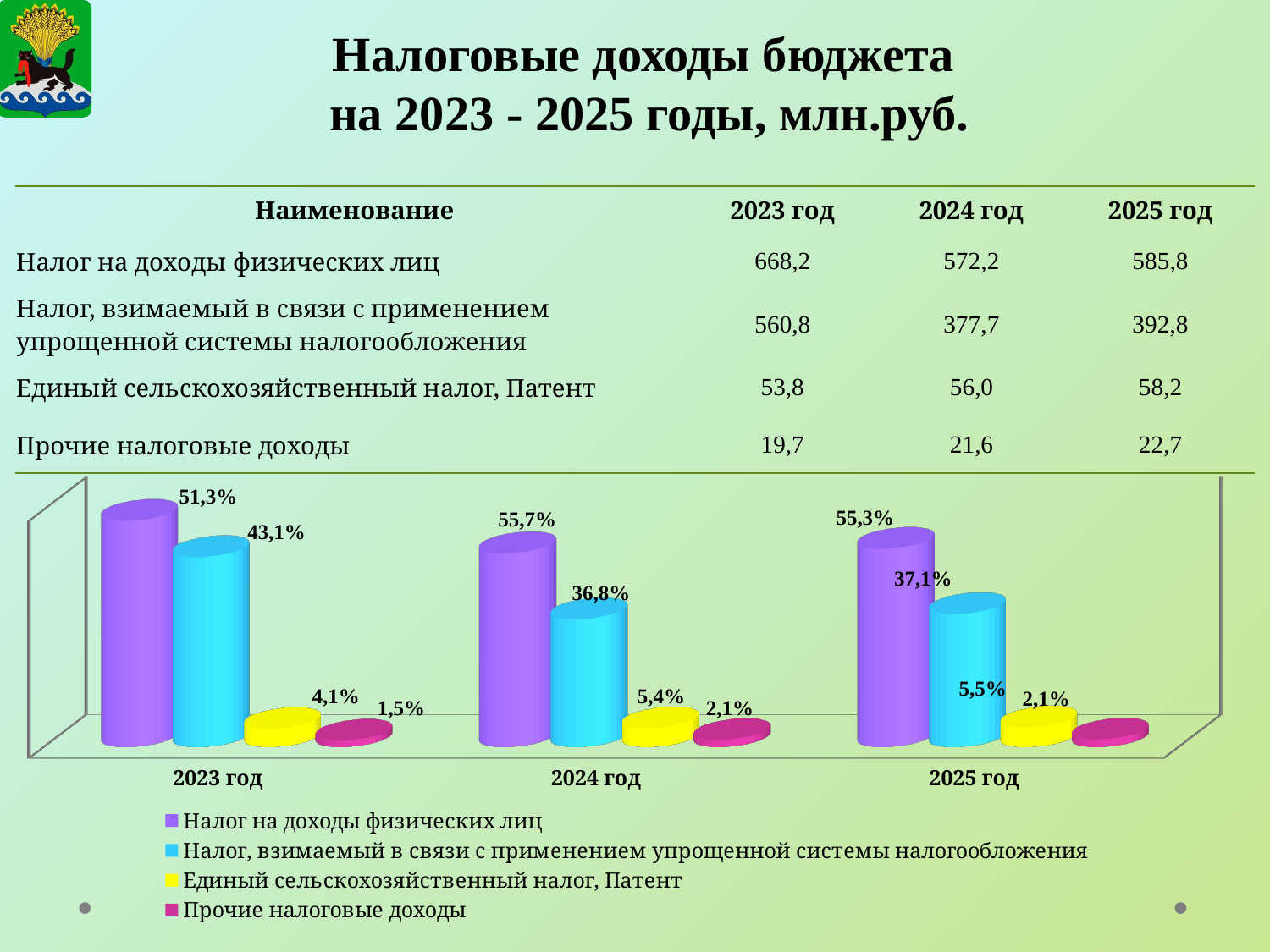
В каком году доля «Налог на доходы физических лиц» на диаграмме наибольшая? 2024 год На сколько процентных пунктов доля «Налог на доходы физических лиц» в 2024 году больше, чем в 2023 году? 4,4 Что больше на диаграмме: доля «Единый сельскохозяйственный налог, Патент» в 2023 году или в 2024 году? 2024 год Какое значение показано на диаграмме для «Прочие налоговые доходы» за 2023 год? 1,5% Каким цветом на диаграмме обозначен ряд «Прочие налоговые доходы»? Малиновым (розовым) Какое значение показано на диаграмме для «Единый сельскохозяйственный налог, Патент» за 2025 год? 5,5% Какого типа диаграмма на слайде? Столбчатая (bar chart) Сколько рядов данных перечислено в легенде диаграммы? 4 Какое значение показано на диаграмме для «Налог, взимаемый в связи с применением упрощенной системы налогообложения» за 2024 год? 36,8% Какое значение показано на диаграмме для «Налог на доходы физических лиц» за 2023 год? 51,3% Сколько категорий (годов) показано по оси x диаграммы? 3 В каком году доля «Налог, взимаемый в связи с применением упрощенной системы налогообложения» на диаграмме наименьшая? 2024 год